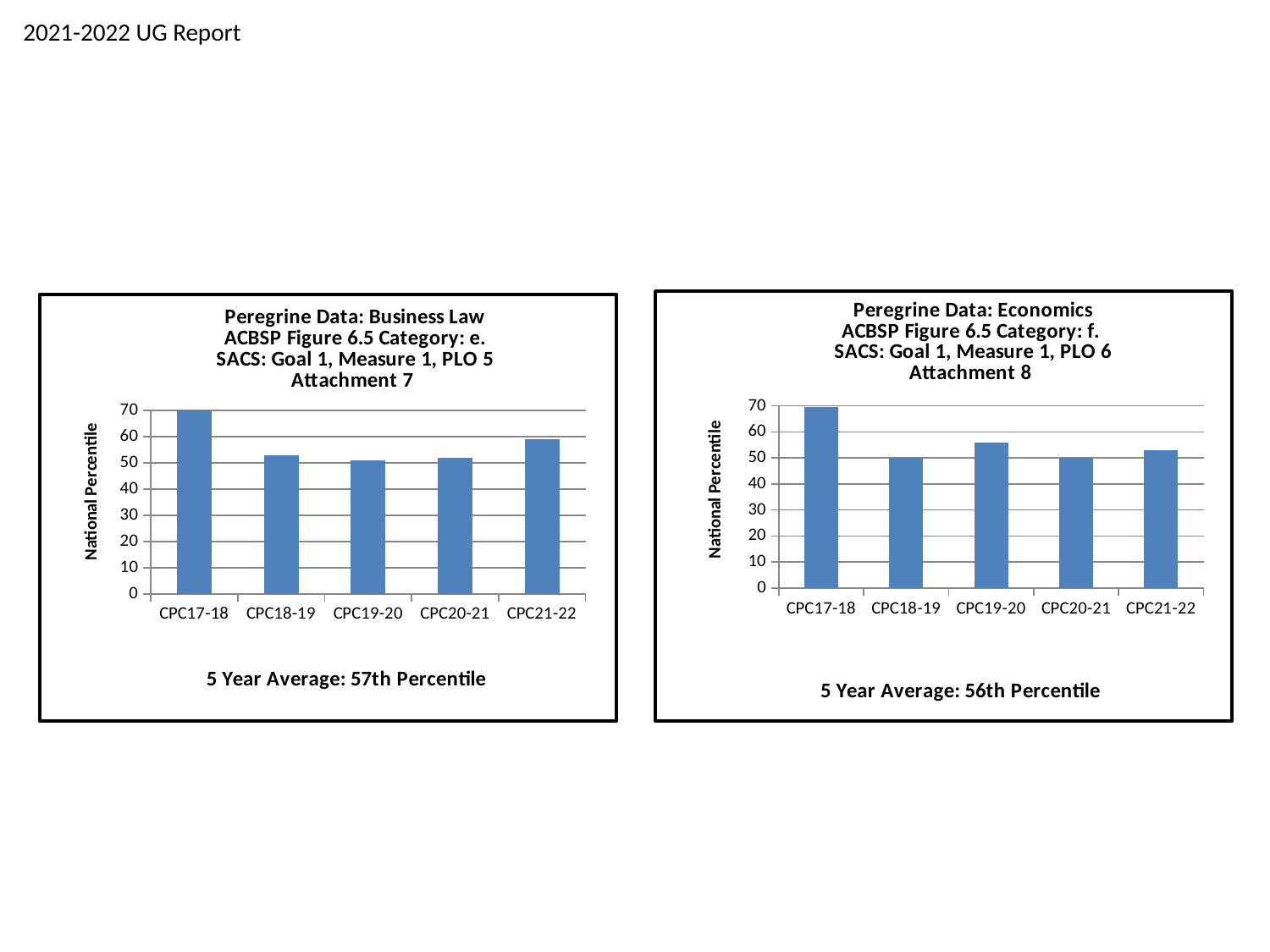
What is the y-axis label of the Peregrine Data: Economics chart? National Percentile In the Peregrine Data: Business Law chart, is the value for CPC18-19 greater or less than 60? less In the Peregrine Data: Economics chart, is the value for CPC21-22 greater or less than 60? less What 5 year average is stated below the Peregrine Data: Business Law chart? 57th Percentile In the Peregrine Data: Economics chart, is the value for CPC19-20 greater or less than 50? greater In the Peregrine Data: Economics chart, which is larger, the value for CPC17-18 or the value for CPC19-20? CPC17-18 In the Peregrine Data: Business Law chart, which category has the highest value? CPC17-18 How many categories are shown on the x axis of the Peregrine Data: Business Law chart? 5 In the Peregrine Data: Economics chart, which category has the highest value? CPC17-18 What kind of chart is the Peregrine Data: Economics chart? bar chart In the Peregrine Data: Business Law chart, which is larger, the value for CPC21-22 or the value for CPC18-19? CPC21-22